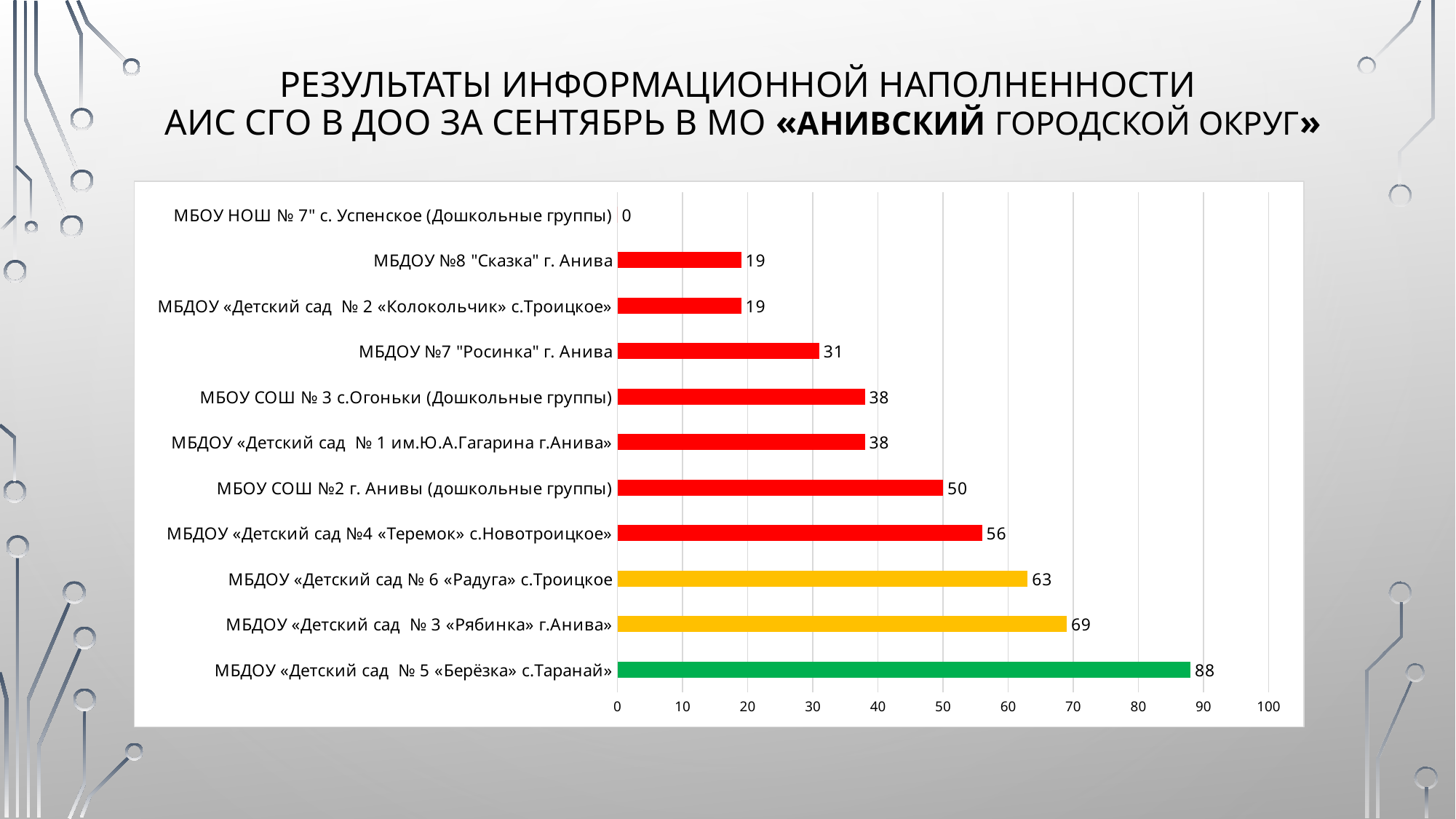
How many categories are shown in the chart? 11 Which category has the lowest value? МБОУ НОШ № 7" с. Успенское (Дошкольные группы) What type of chart is shown on the slide? bar chart What is the value for МБОУ СОШ №2 г. Анивы (дошкольные группы)? 50 Which category has the highest value? МБДОУ «Детский сад № 5 «Берёзка» с.Таранай» How many bars are coloured yellow? 2 Which is larger: the value for МБДОУ «Детский сад №4 «Теремок» с.Новотроицкое» or the value for МБОУ СОШ № 3 с.Огоньки (Дошкольные группы)? МБДОУ «Детский сад №4 «Теремок» с.Новотроицкое» What is the difference between the values for МБДОУ «Детский сад № 5 «Берёзка» с.Таранай» and МБДОУ №8 "Сказка" г. Анива? 69 What is the difference between the values for МБДОУ «Детский сад № 3 «Рябинка» г.Анива» and МБДОУ «Детский сад № 6 «Радуга» с.Троицкое? 6 What colour is the bar for МБДОУ «Детский сад № 5 «Берёзка» с.Таранай»? green What is the value for МБДОУ «Детский сад № 5 «Берёзка» с.Таранай»? 88 What is the value for МБДОУ №7 "Росинка" г. Анива? 31